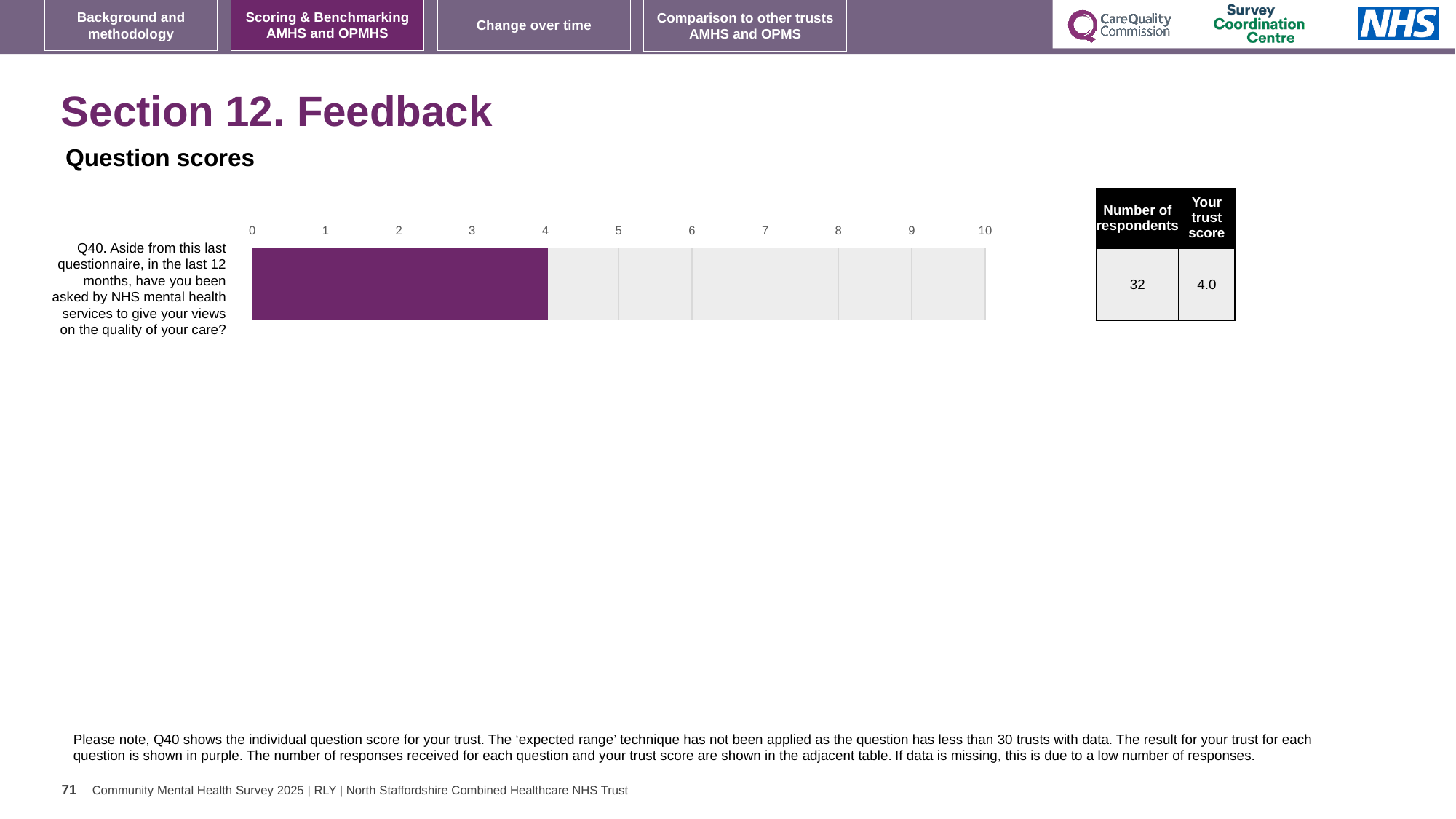
What kind of chart is used to show the Q40 score? Bar chart Is the value for Q40 greater or less than 3? greater Which question number is plotted in the chart? Q40 How many respondents answered Q40 according to the table? 32 What colour is the bar representing the trust's score for Q40? Purple What is the maximum value shown on the chart's x axis? 10 Is the value for Q40 greater or less than 5? less What is the trust score for Q40 shown on the slide? 4.0 How many questions (bars) are plotted in the chart? 1